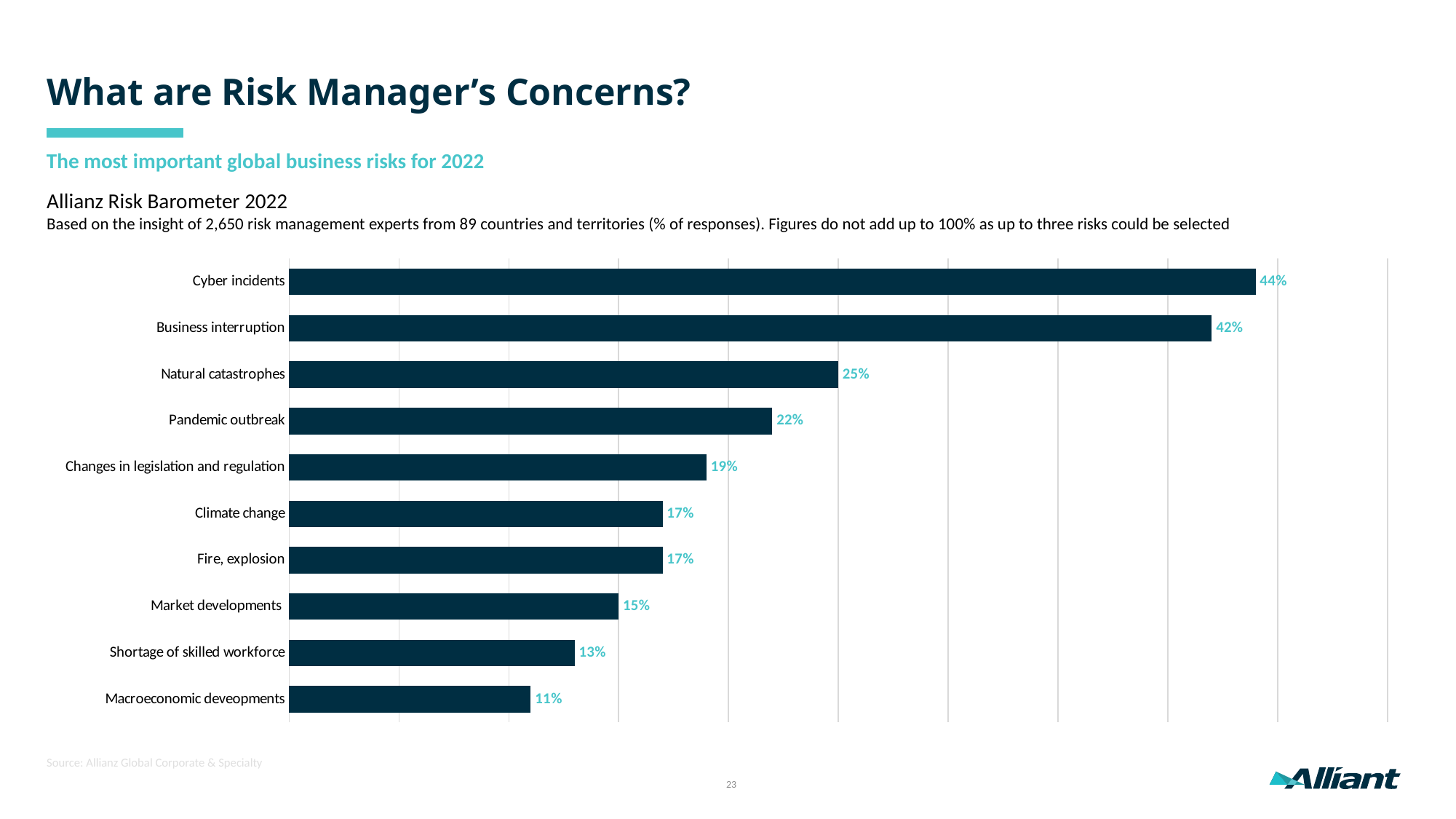
Which has a higher value, Changes in legislation and regulation or Market developments? Changes in legislation and regulation Which two risks share the same value of 17%? Climate change and Fire, explosion What percentage is shown for Shortage of skilled workforce? 13% How many risk categories are shown in the chart? 10 What is the value shown for Natural catastrophes? 25% What kind of chart is shown on the slide? Bar chart What percentage of responses selected Cyber incidents? 44% Which risk has the highest percentage of responses? Cyber incidents What is the difference in percentage points between Natural catastrophes and Pandemic outbreak? 3 Which risk has the lowest percentage of responses? Macroeconomic deveopments What is the difference in percentage points between Cyber incidents and Business interruption? 2 What is the subtitle of the chart shown on the slide? The most important global business risks for 2022